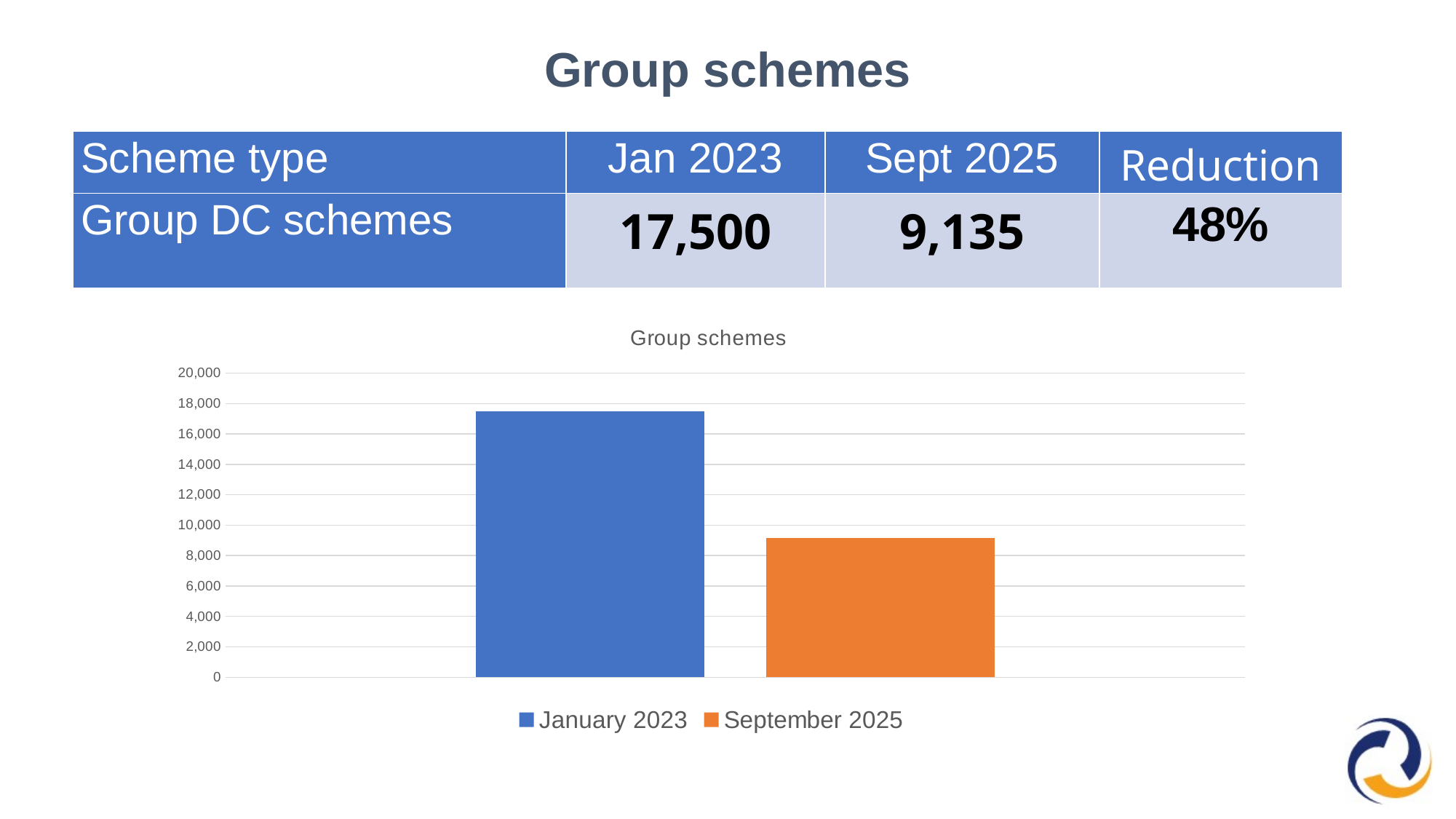
Do the bar values rise or fall from January 2023 to September 2025? fall What is the title of the chart? Group schemes What kind of chart is shown on the slide? bar chart Which series is shown in orange in the chart? September 2025 Is the value for January 2023 greater or less than 16,000? greater Is the value for September 2025 greater or less than 8,000? greater Which series has the taller bar, January 2023 or September 2025? January 2023 How many series does the chart legend list? 2 Which series has the highest bar in the chart? January 2023 How many bars are plotted in the chart? 2 Which series has the lowest bar in the chart? September 2025 Is the value for September 2025 greater or less than 10,000? less